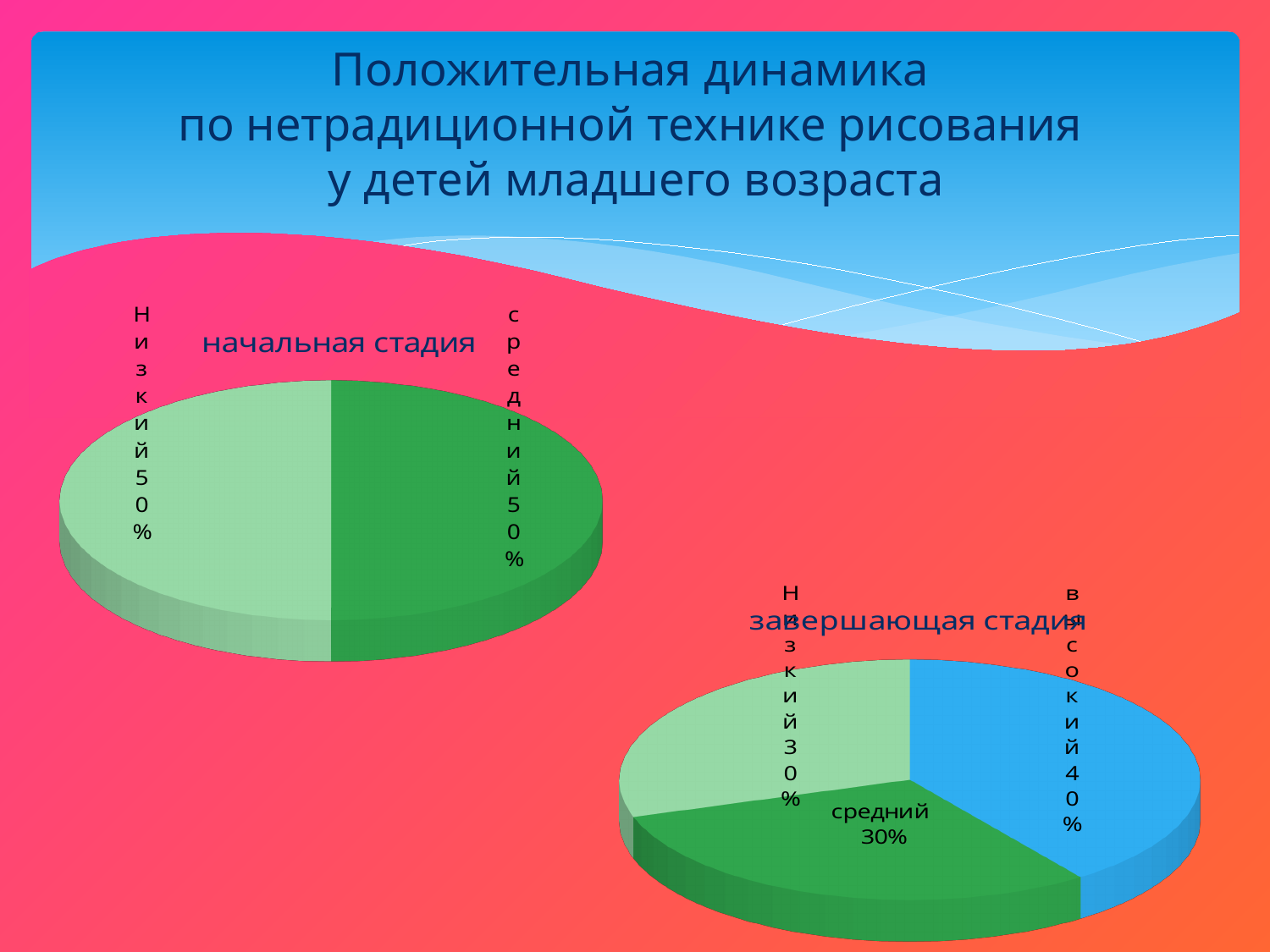
How many slices does the 'начальная стадия' pie chart have? 2 In the 'начальная стадия' chart, what is the value for 'Низкий'? 50% In the 'завершающая стадия' chart, which category has the largest share? высокий In the 'завершающая стадия' chart, what is the value for 'высокий'? 40% What kind of chart is the 'начальная стадия' chart? pie chart In the 'завершающая стадия' chart, which is larger: 'высокий' or 'средний'? высокий How many slices does the 'завершающая стадия' pie chart have? 3 In the 'завершающая стадия' chart, what is the value for 'Низкий'? 30% What is the title of the pie chart on the right side of the slide? завершающая стадия In the 'начальная стадия' chart, what is the value for 'средний'? 50% In the 'завершающая стадия' chart, what is the value for 'средний'? 30% In the 'завершающая стадия' chart, what is the difference between 'высокий' and 'Низкий'? 10%